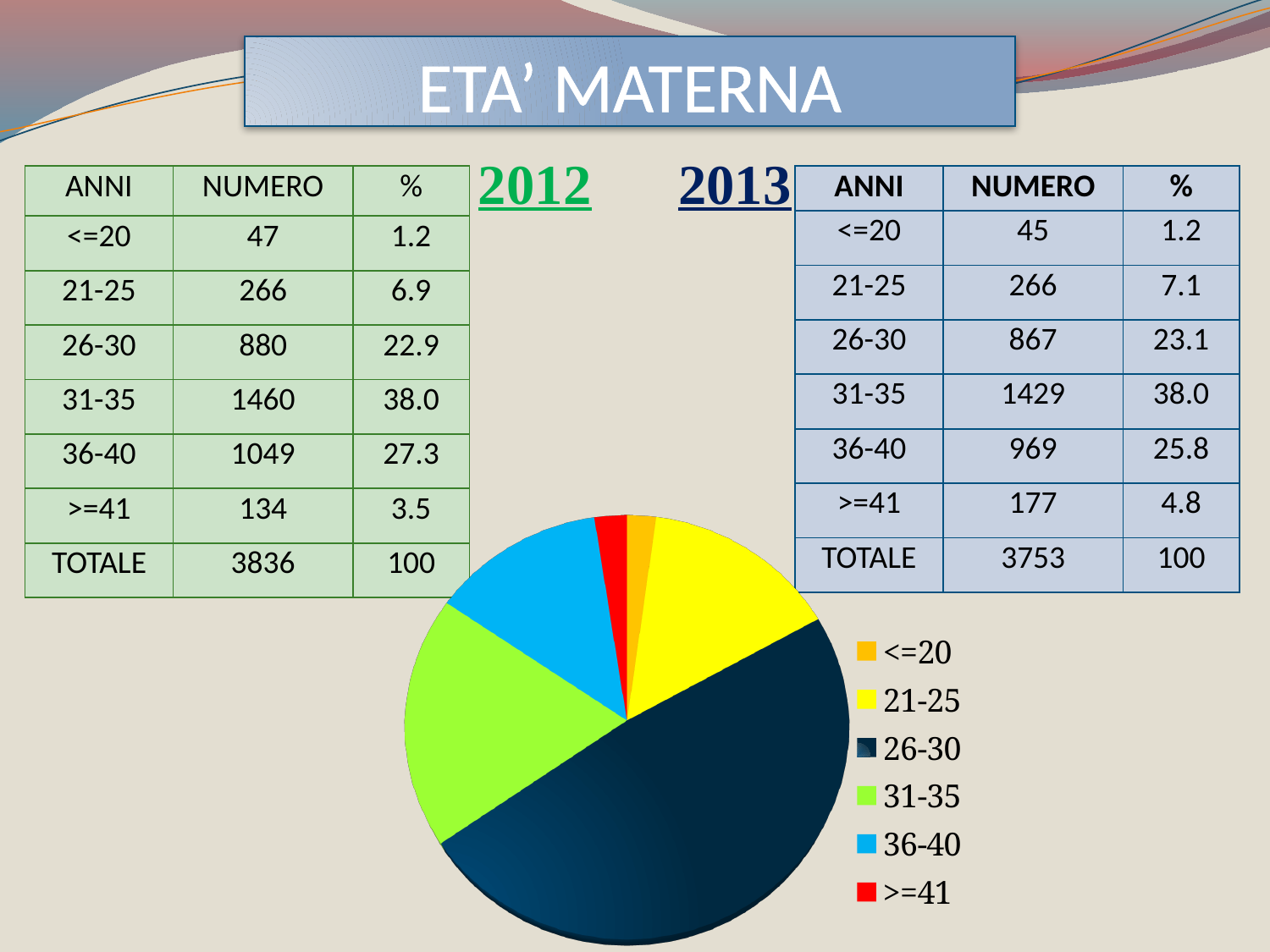
In the pie chart, which slice is larger: 31-35 or 36-40? 31-35 In the pie chart, which slice is larger: 31-35 or >=41? 31-35 In the pie chart, which slice is larger: 26-30 or 21-25? 26-30 Which category has the largest slice in the pie chart? 26-30 What colour is the 26-30 slice in the pie chart? dark blue How many categories does the pie chart's legend list? 6 What colour is the >=41 slice in the pie chart? red What kind of chart is shown on the slide? pie chart